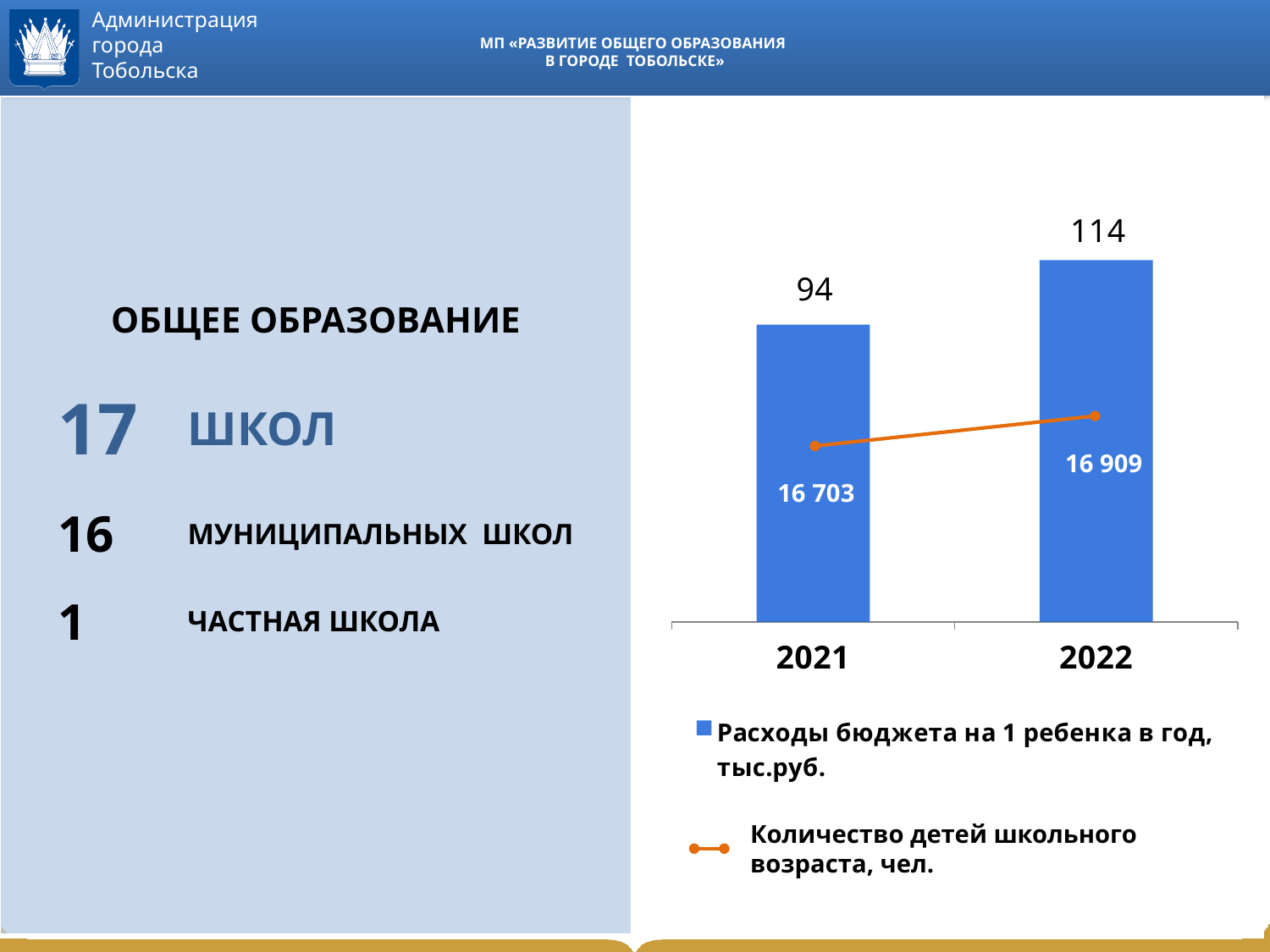
What is the value of budget expenses per child per year (тыс.руб.) for 2022? 114 How many school-age children (чел.) are shown for 2022? 16 909 By how much did budget expenses per child (тыс.руб.) increase from 2021 to 2022? 20 Do the budget expenses per child rise or fall from 2021 to 2022? rise What is the difference in the number of school-age children between 2022 and 2021? 206 What is the value of budget expenses per child per year (тыс.руб.) for 2021? 94 How many series does the chart legend list? 2 How many school-age children (чел.) are shown for 2021? 16 703 How many years are shown on the x axis of the chart? 2 Which year has the higher budget expenses per child? 2022 Which year has the lower number of school-age children? 2021 Is the number of school-age children larger in 2021 or in 2022? 2022